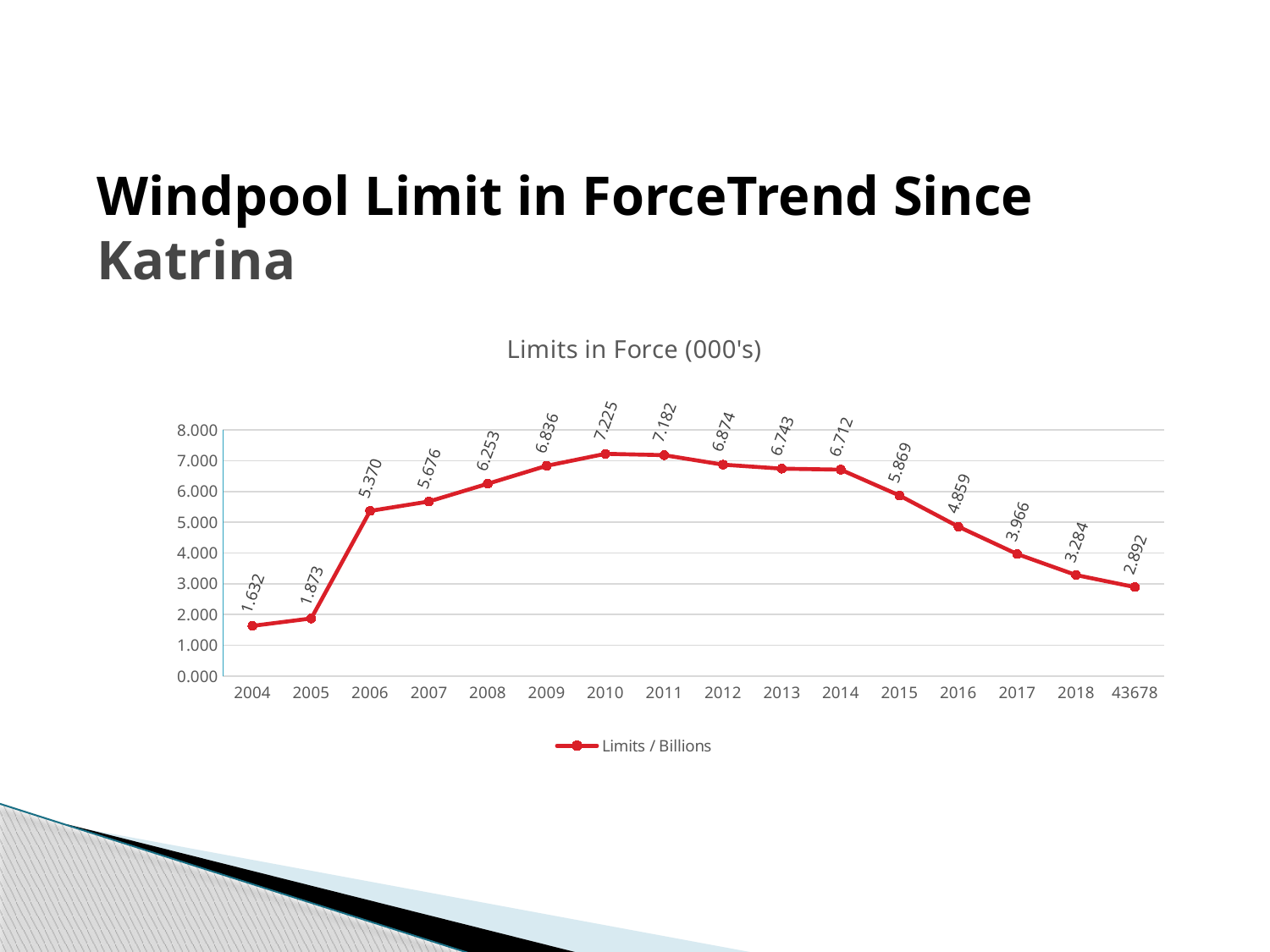
What is the value for 2016? 4.859 Which year has the highest value? 2010 What kind of chart is shown? line chart Is the value for 2017 greater or less than 4.000? less Do the values rise or fall from 2014 to 2018? fall What is the difference between the values for 2006 and 2005? 3.497 How many data points are plotted on the chart? 16 Which is larger, the value for 2012 or the value for 2015? 2012 Which category has the lowest value? 2004 What is the value for 2010? 7.225 How many series does the legend list? 1 What is the value for 2004? 1.632